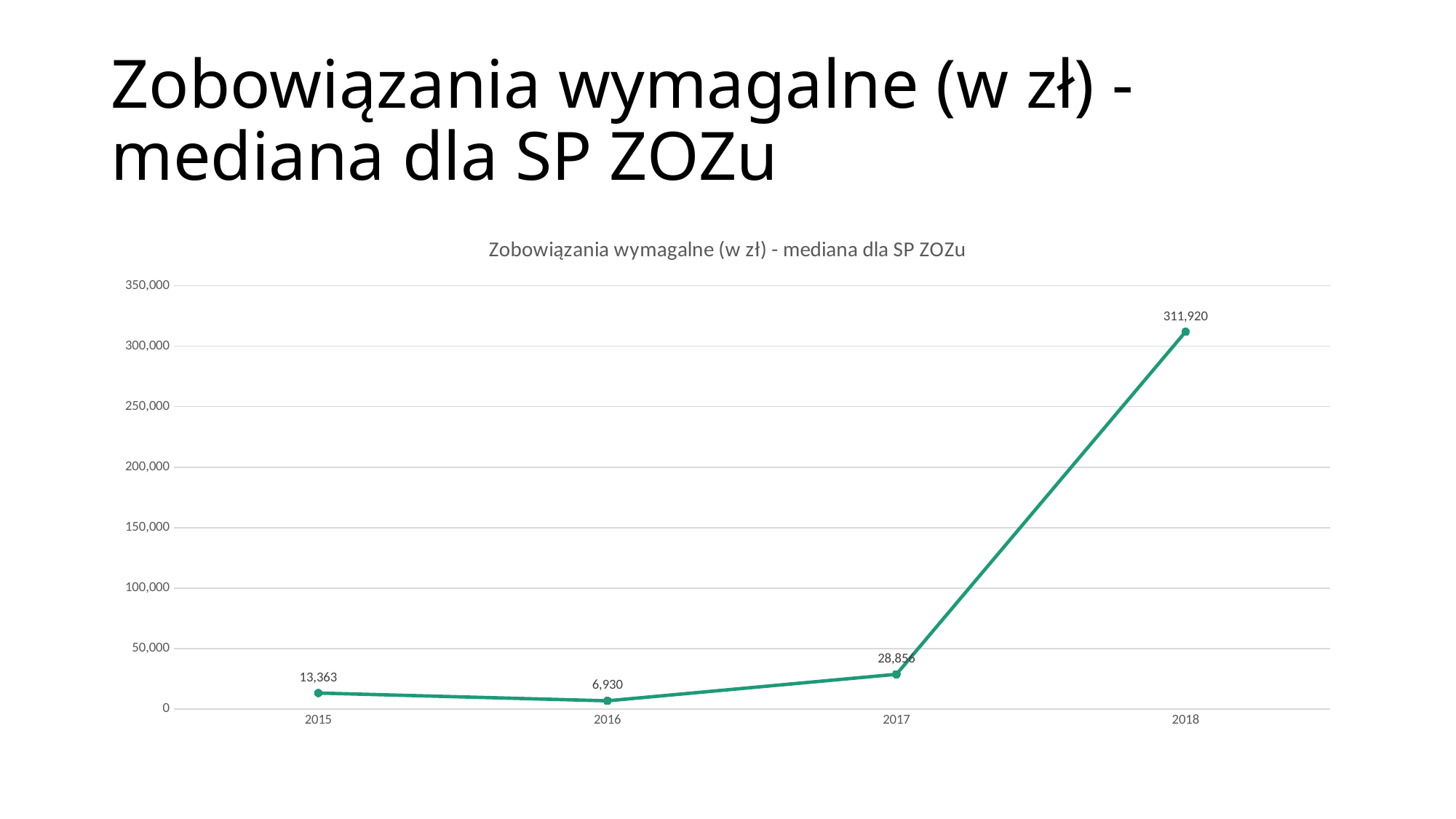
What is the difference between the values for 2015 and 2016? 6,433 What is the value for 2015? 13,363 Which is larger, the value for 2015 or the value for 2017? 2017 What is the value for 2016? 6,930 Which year has the lowest value? 2016 How many years are plotted on the chart? 4 Which year has the highest value? 2018 What is the value for 2017? 28,856 Is the value for 2018 greater or less than 300,000? greater What is the value for 2018? 311,920 What is the difference between the values for 2018 and 2017? 283,064 What kind of chart is shown on the slide? line chart